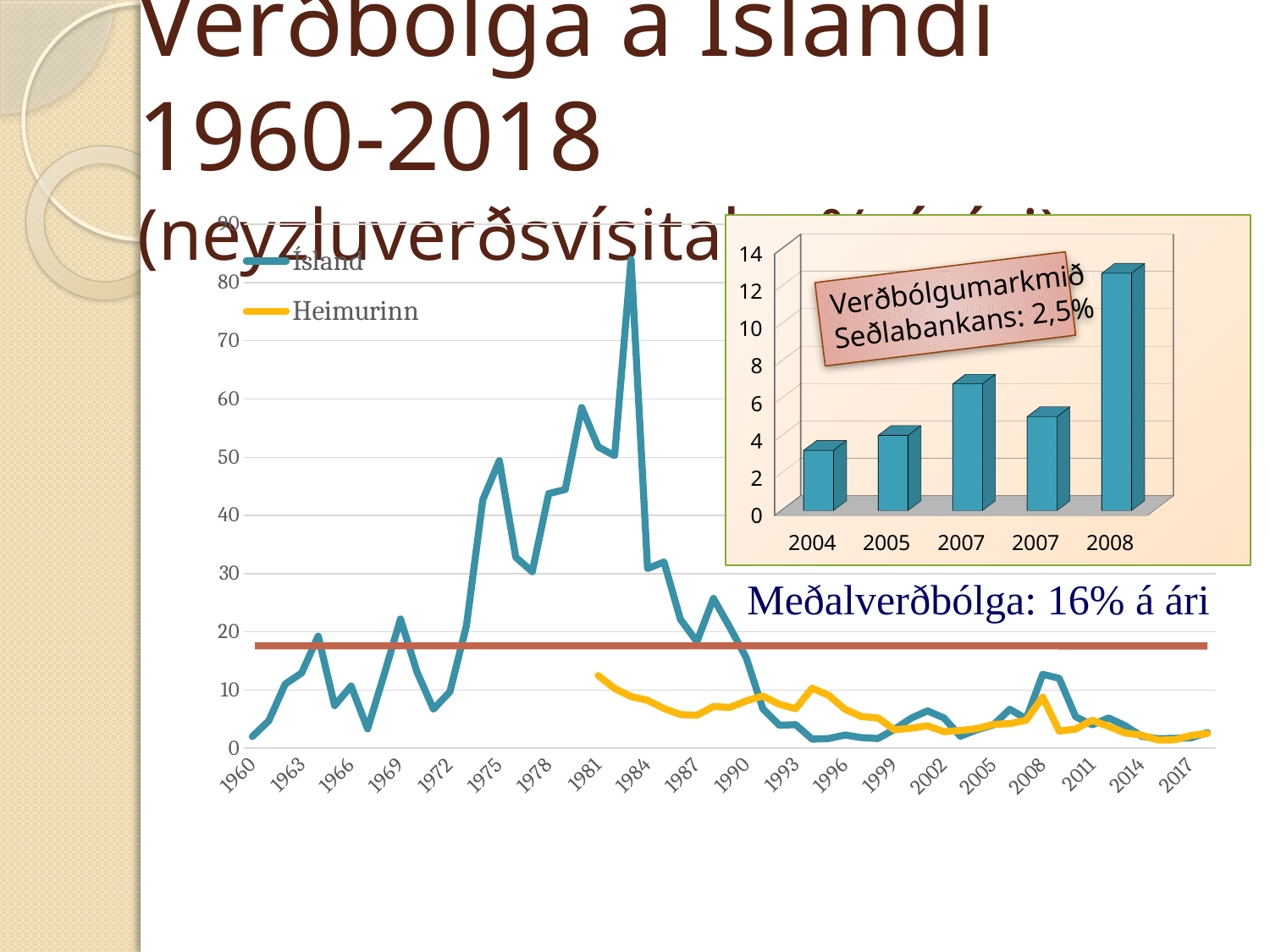
In the large line chart, is the value for Ísland in 1960 greater or less than 10? less How many bars does the inset bar chart in the upper right show? 5 In the inset bar chart, which year has the highest bar? 2008 In the large line chart, in which year does the Ísland series reach its highest value? 1983 What are the two series named in the legend of the large line chart? Ísland and Heimurinn What kind of chart is the inset chart in the upper right of the slide? bar chart In the large line chart, which series has the larger value in 1983, Ísland or Heimurinn? Ísland How many series does the legend of the large line chart list? 2 In the inset bar chart, which bar is taller, 2005 or 2008? 2008 In the large line chart, is the peak value of the Ísland series greater or less than 80? greater In the inset bar chart, is the value for 2008 greater or less than 12? greater What kind of chart is the large chart on the left of the slide? line chart